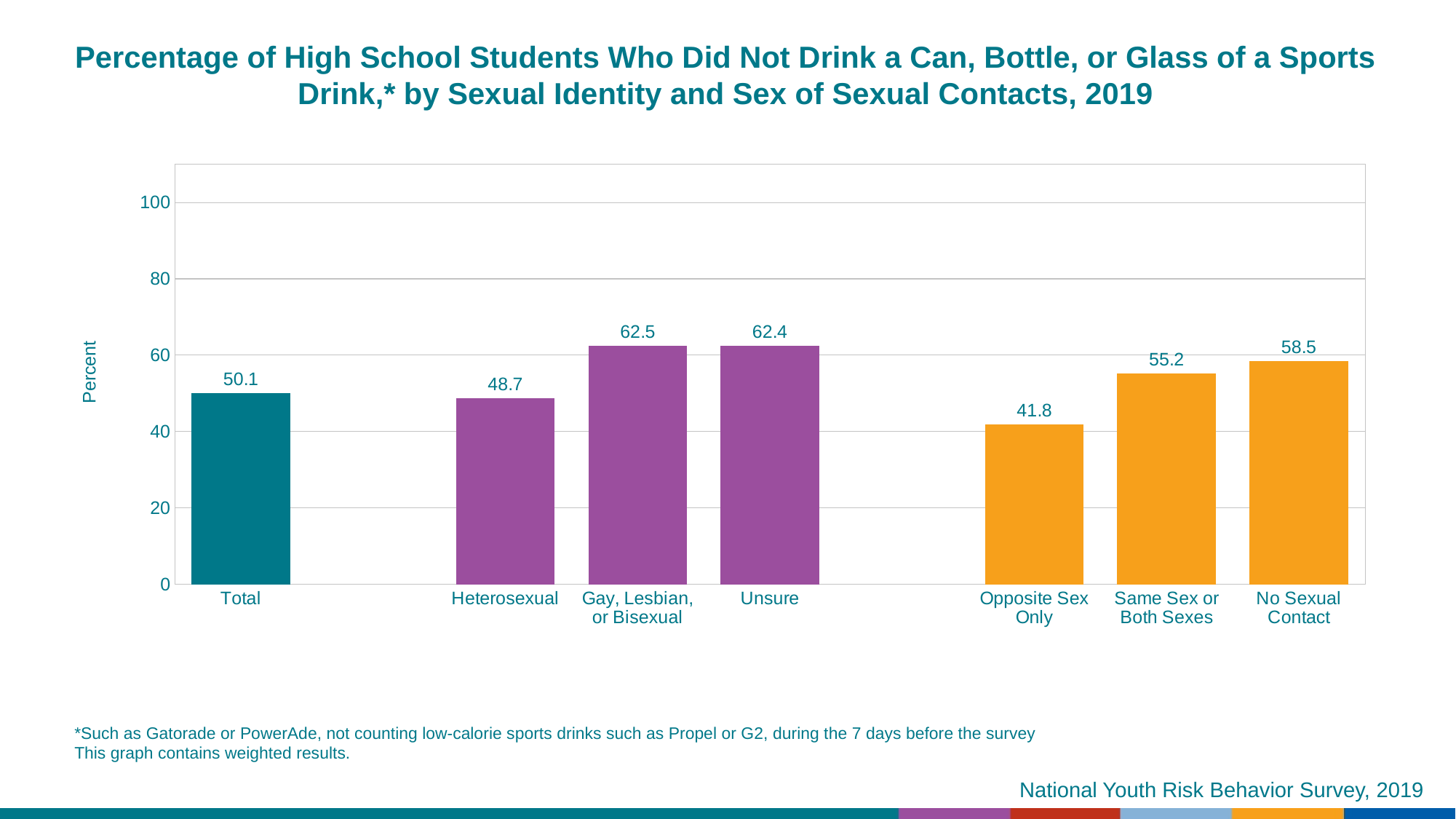
What is the value for Heterosexual students? 48.7 Which category has the highest value? Gay, Lesbian, or Bisexual What is the value for students with No Sexual Contact? 58.5 How many bars are shown in the chart? 7 What kind of chart is shown on the slide? Bar chart What is the value for Opposite Sex Only? 41.8 Which category has the lowest value? Opposite Sex Only Which is larger, the value for Heterosexual or the value for Unsure? Unsure What is the value for Total? 50.1 Is the value for Same Sex or Both Sexes greater or less than 60? less What is the label of the y axis? Percent What is the difference between the values for Same Sex or Both Sexes and Opposite Sex Only? 13.4